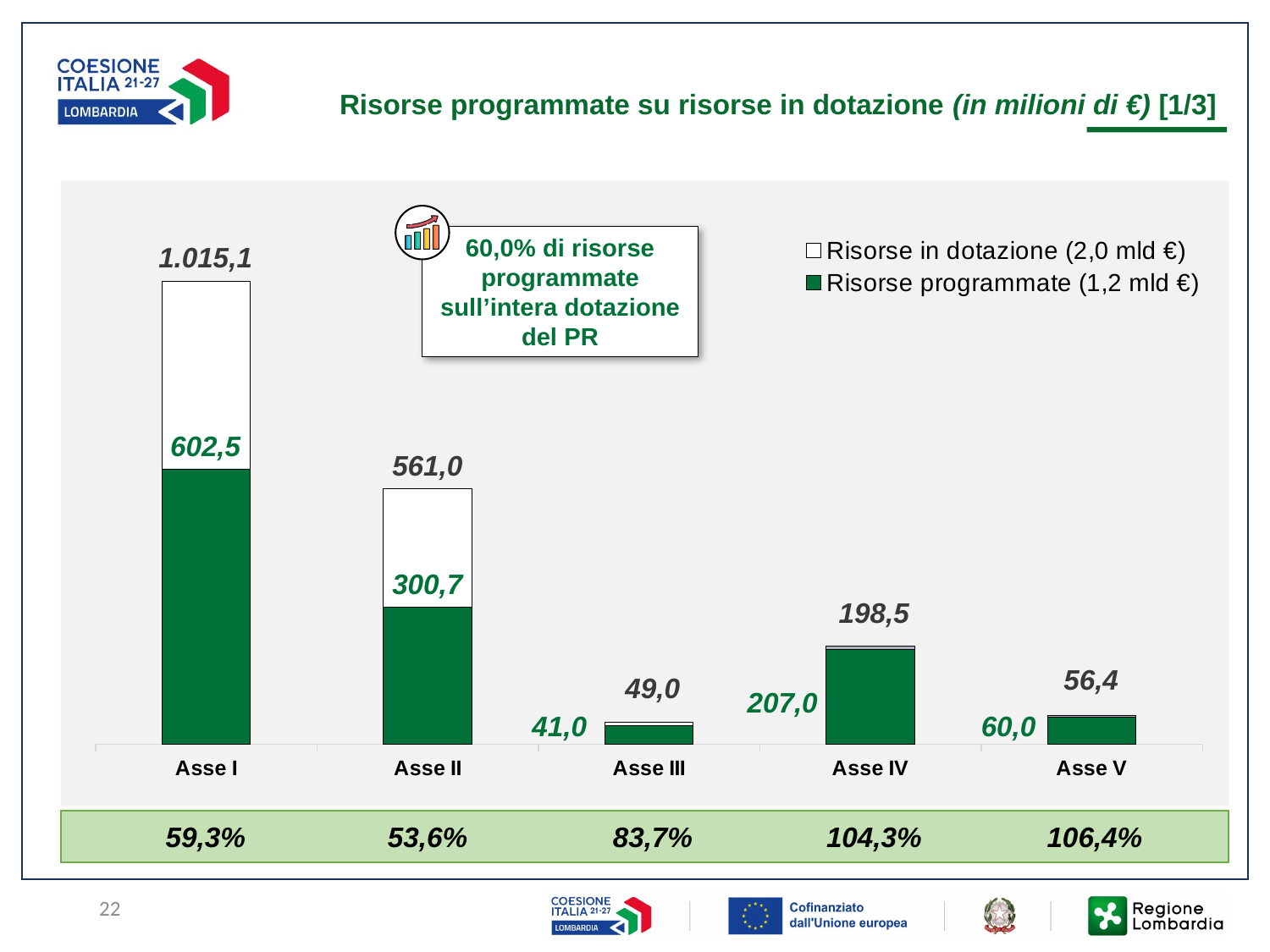
For Asse IV, which is larger: Risorse in dotazione or Risorse programmate? Risorse programmate How many categories (Assi) are shown on the x axis? 5 What is the value of Risorse programmate for Asse IV? 207,0 How many series does the legend list? 2 What is the difference between Risorse in dotazione and Risorse programmate for Asse I? 412,6 What is the difference between Risorse in dotazione and Risorse programmate for Asse II? 260,3 What kind of chart is shown on the slide? Bar chart What is the value of Risorse in dotazione for Asse I? 1.015,1 What is the value of Risorse in dotazione for Asse V? 56,4 Which category has the lowest value of Risorse programmate? Asse III Which category has the highest value of Risorse in dotazione? Asse I What is the value of Risorse programmate for Asse II? 300,7